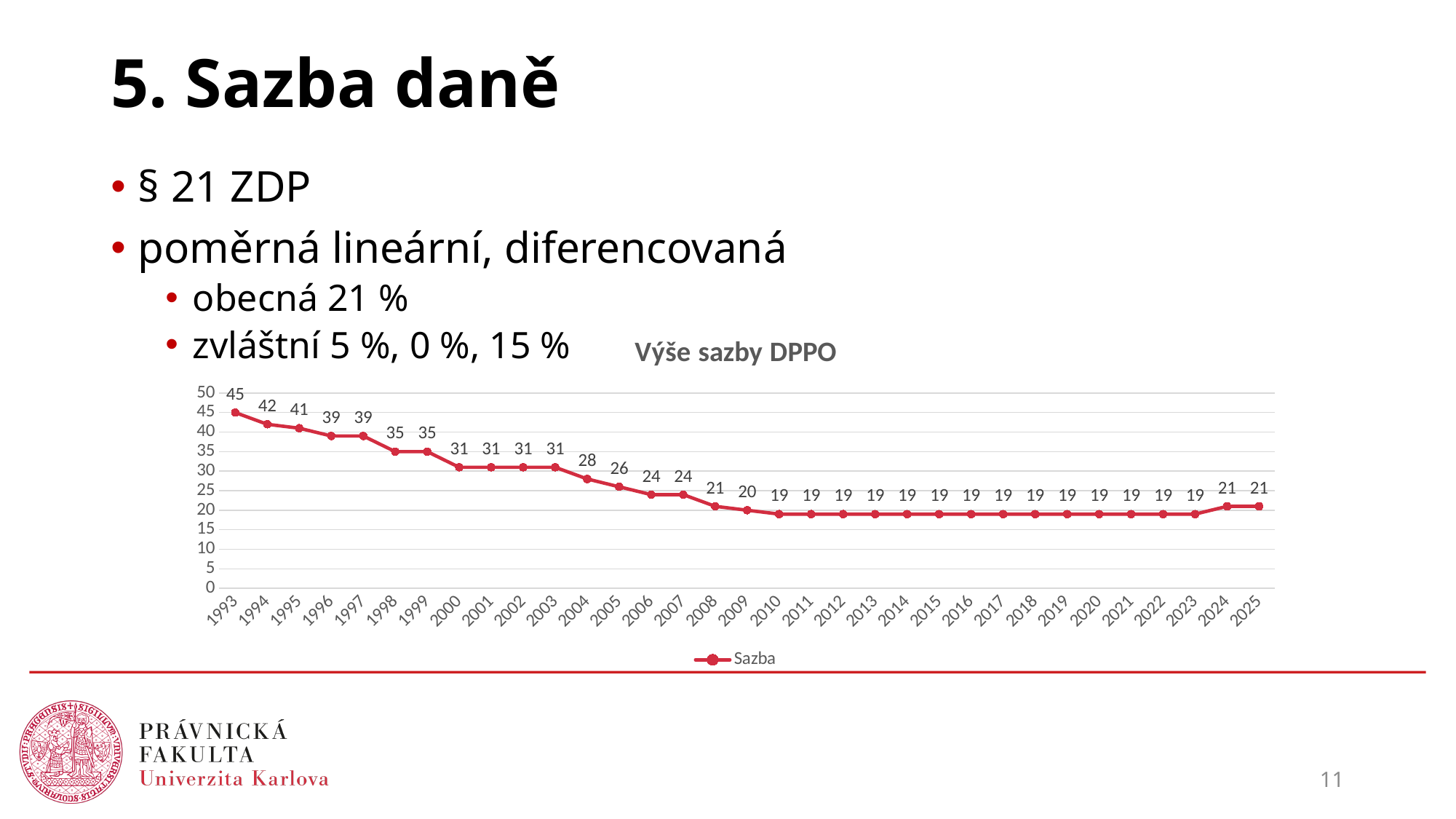
What is the value for 1993 in the chart? 45 What kind of chart is shown on the slide? line chart What is the value for 2004 in the chart? 28 How many series does the legend list? 1 Is the value for 1998 greater or less than 30? greater How many years are plotted on the x axis of the chart? 33 What is the lowest value shown in the chart? 19 Which year has the highest value in the chart? 1993 What is the difference between the values for 1993 and 2010? 26 Which is larger, the value for 2000 or the value for 2008? 2000 What is the title of the chart? Výše sazby DPPO What is the value for 2025 in the chart? 21